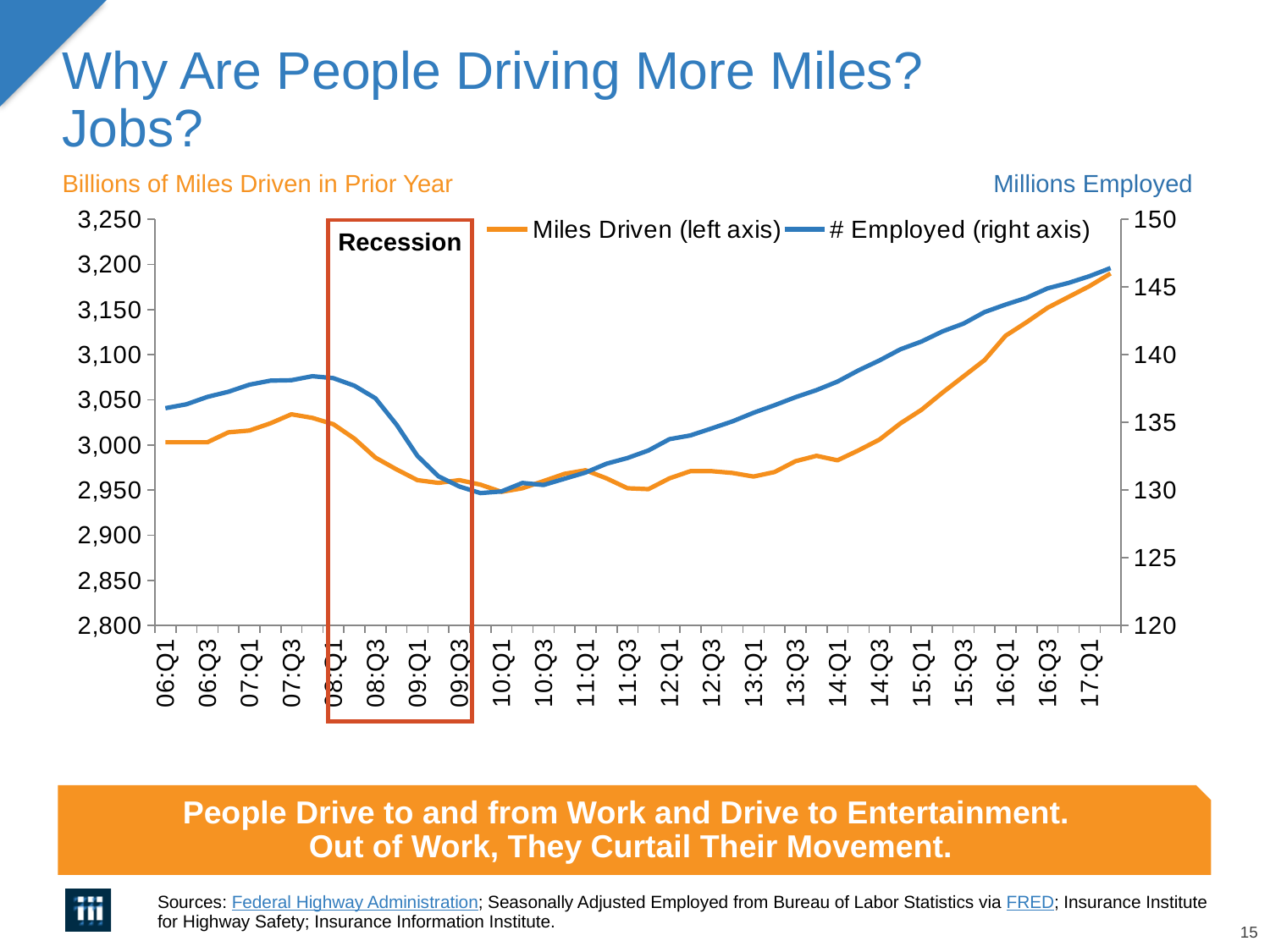
Is the Miles Driven value at 10:Q1 greater or less than 3,000? less What label is written inside the red box on the chart? Recession Does the Miles Driven series rise or fall between 14:Q1 and 17:Q1? rise Is the # Employed value at 09:Q3 greater or less than 135? less What are the two series named in the legend? Miles Driven (left axis) and # Employed (right axis) Is the # Employed value at 17:Q1 greater or less than 145? greater What kind of chart is shown on the slide? Line chart Does the # Employed series rise or fall between 08:Q1 and 09:Q3? fall How many series does the chart's legend list? 2